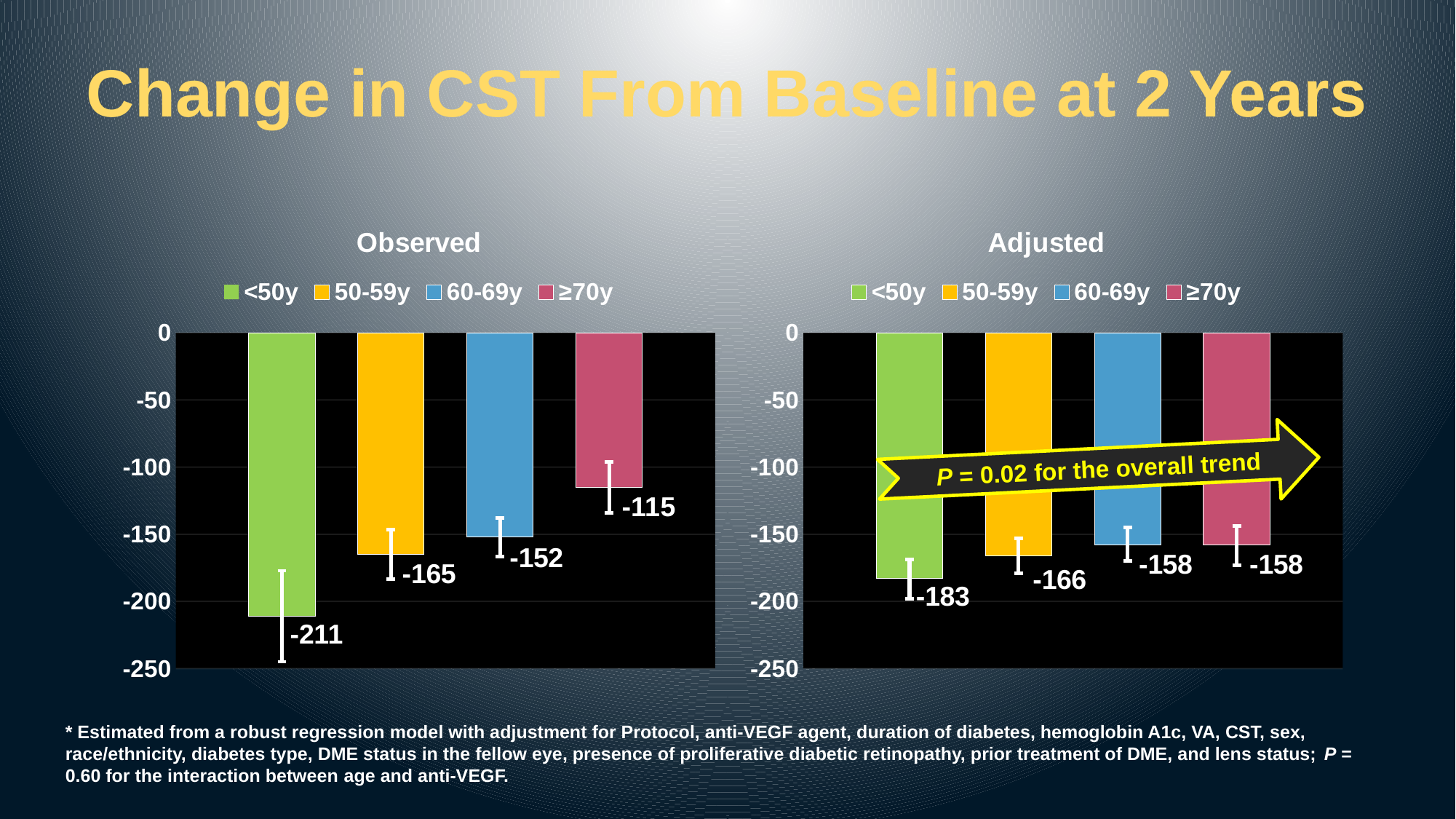
In the Adjusted chart, what is the difference between the values for the <50y group and the 50-59y group? 17 In the Observed chart, what is the value for the ≥70y group? -115 In the Adjusted chart, what is the value for the 50-59y group? -166 In the Observed chart, is the bar for the 60-69y group more negative than the bar for the 50-59y group? No In the Observed chart, what is the value for the <50y group? -211 In the Observed chart, what is the difference between the values for the <50y group and the ≥70y group? 96 In the Observed chart, which age group shows the smallest decrease in CST (the value closest to 0)? ≥70y How many age groups does the legend of the Adjusted chart list? 4 In the Observed chart, which age group shows the largest decrease in CST (the most negative value)? <50y What type of chart is used for the Observed data? Bar chart In the Adjusted chart, which age group has the most negative value? <50y In the Adjusted chart, what is the value for the 60-69y group? -158